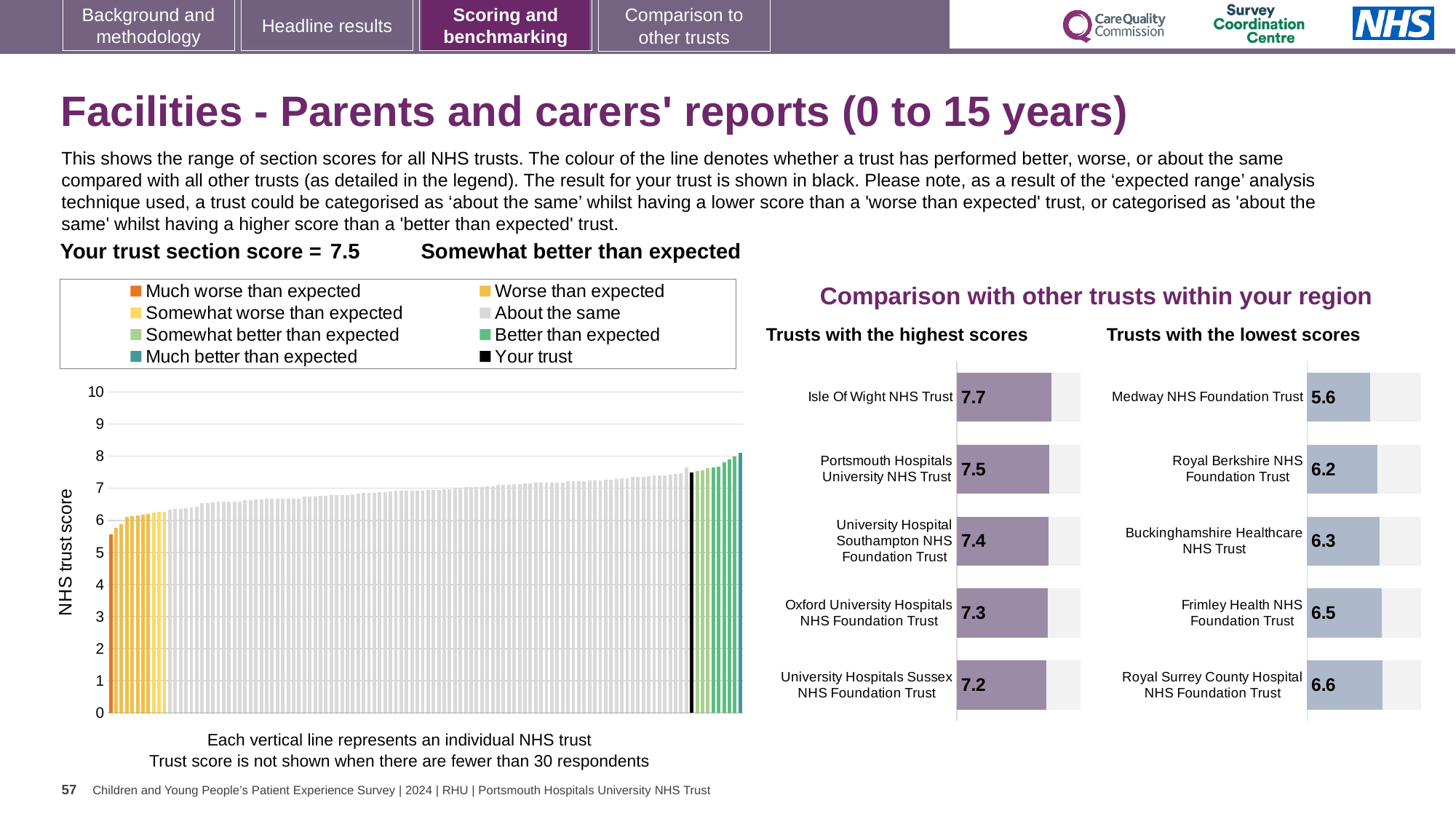
How many entries does the legend above the large chart on the left list? 8 In the large chart on the left, is the value of the leftmost (orange) bar greater or less than 6? less In the 'Trusts with the lowest scores' chart, which has the larger score: Royal Berkshire NHS Foundation Trust or Frimley Health NHS Foundation Trust? Frimley Health NHS Foundation Trust In the large chart on the left, do the trust scores rise or fall from left to right? Rise What type of chart is the large chart on the left showing NHS trust scores? Bar chart In the 'Trusts with the lowest scores' chart, what is the score for Medway NHS Foundation Trust? 5.6 How many trusts are listed in the 'Trusts with the lowest scores' chart? 5 In the 'Trusts with the highest scores' chart, what is the score for Oxford University Hospitals NHS Foundation Trust? 7.3 In the 'Trusts with the highest scores' chart, what is the difference between the scores of Isle Of Wight NHS Trust and University Hospitals Sussex NHS Foundation Trust? 0.5 In the 'Trusts with the lowest scores' chart, which trust has the highest score? Royal Surrey County Hospital NHS Foundation Trust In the 'Trusts with the highest scores' chart, which trust has the lowest score? University Hospitals Sussex NHS Foundation Trust In the 'Trusts with the highest scores' chart, what is the score for Isle Of Wight NHS Trust? 7.7